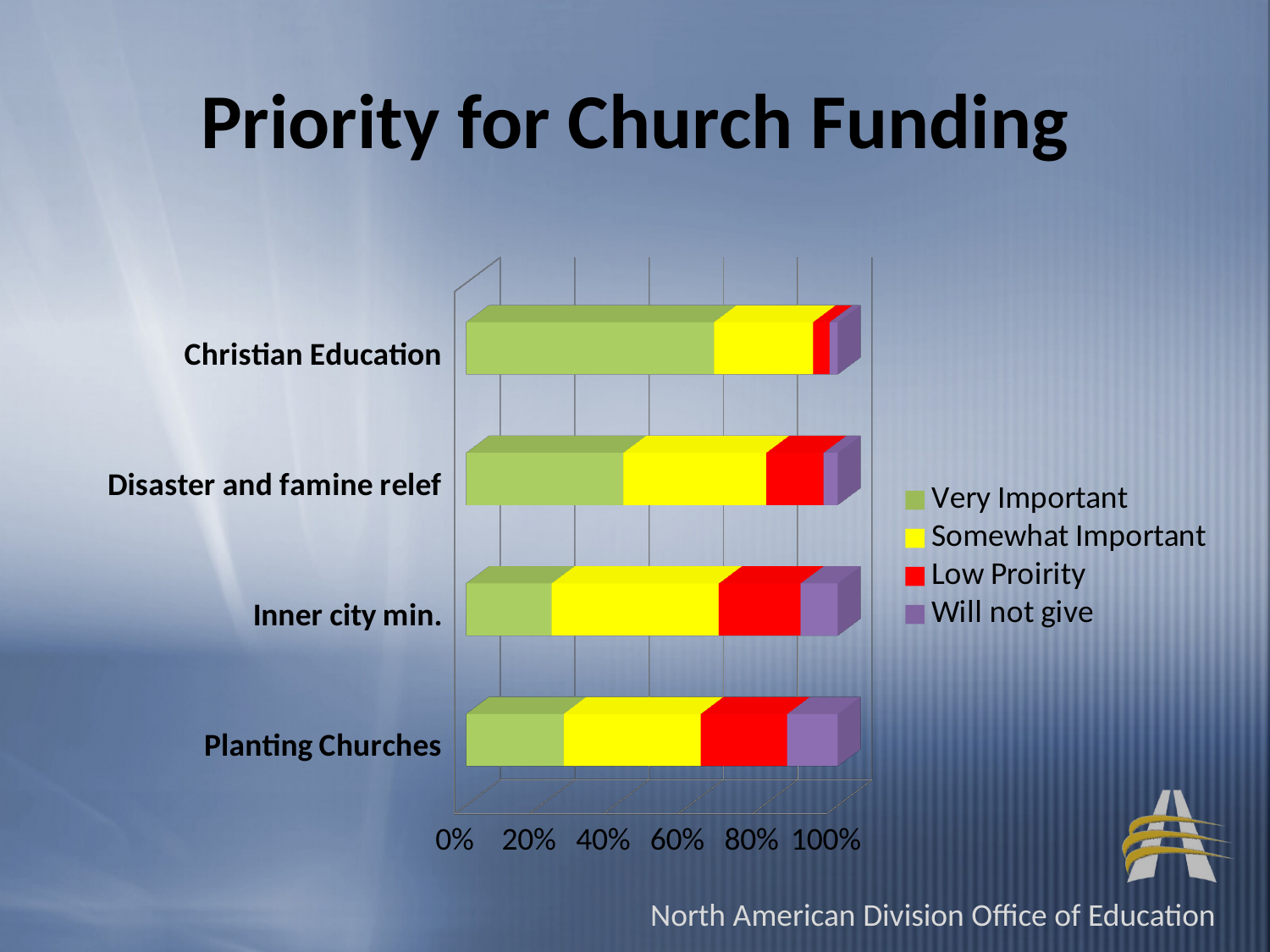
Is the 'Very Important' value for Inner city min. greater or less than 40%? less Which category has the largest 'Very Important' segment? Christian Education What is the title of the chart? Priority for Church Funding Is the 'Very Important' value for Christian Education greater or less than 60%? greater Which category has the largest 'Will not give' segment? Planting Churches How many series does the legend list? 4 Which has a larger 'Very Important' segment, Christian Education or Planting Churches? Christian Education How many categories are plotted on the chart? 4 What kind of chart is shown on the slide? Stacked bar chart Which series is shown in red in the legend? Low Proirity Which has a larger 'Will not give' segment, Planting Churches or Christian Education? Planting Churches Which category has the smallest 'Low Proirity' segment? Christian Education